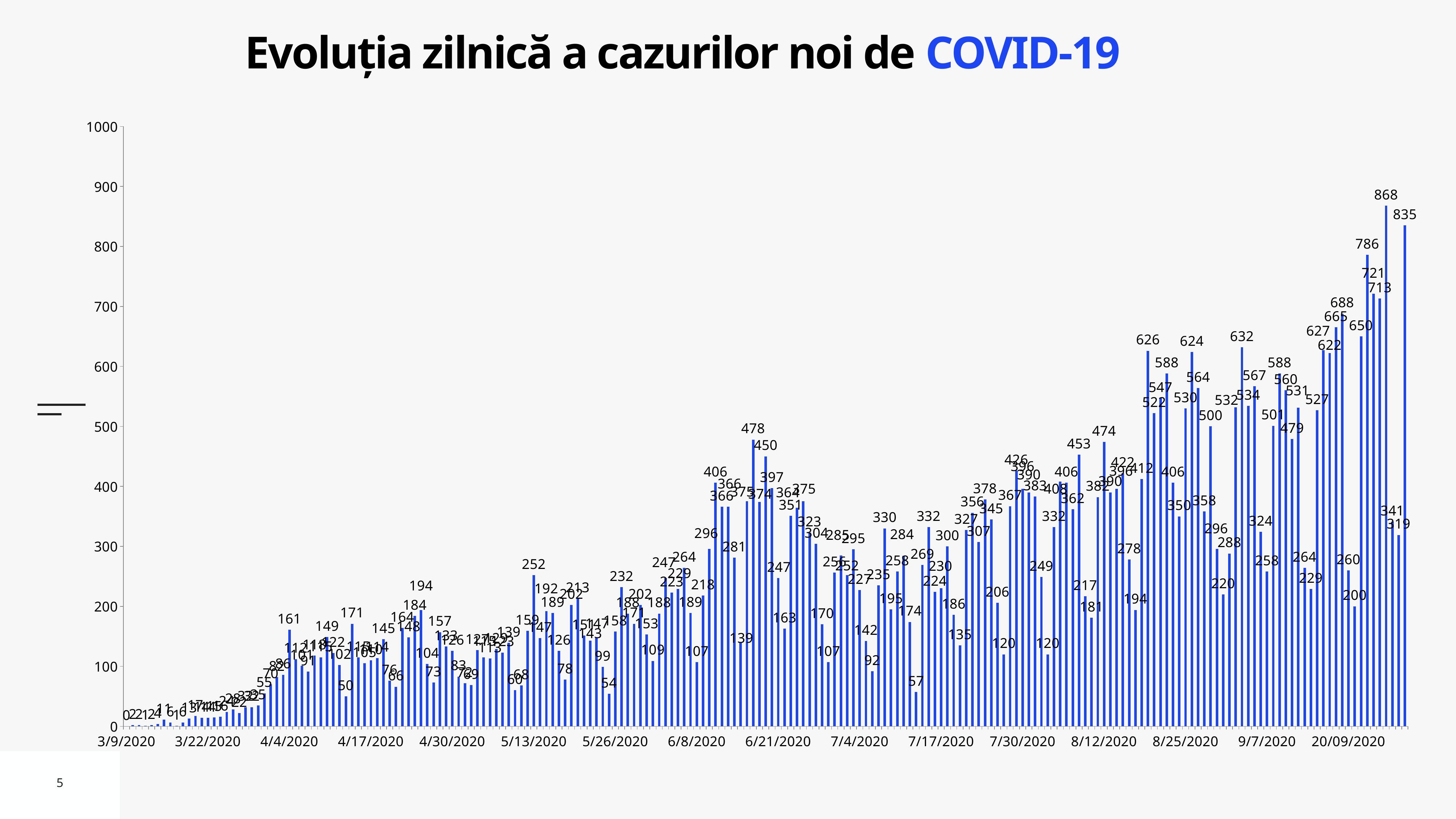
What is the title of the chart? Evoluția zilnică a cazurilor noi de COVID-19 Is the bar labelled 786 greater or less than 700? greater What is the difference between the two highest values, 868 and 835? 33 Is the highest bar on the chart greater or less than 900? less What is the value of the first bar, at 3/9/2020? 0 Which is larger, the bar labelled 868 or the bar labelled 786? 868 What is the lowest value printed on the chart? 0 What is the highest daily value printed on the chart? 868 What colour are the bars in the chart? blue What is the value of the rightmost (last) bar on the chart? 835 Overall, do the daily values rise or fall from left to right along the x axis? rise What kind of chart is shown on the slide? bar chart